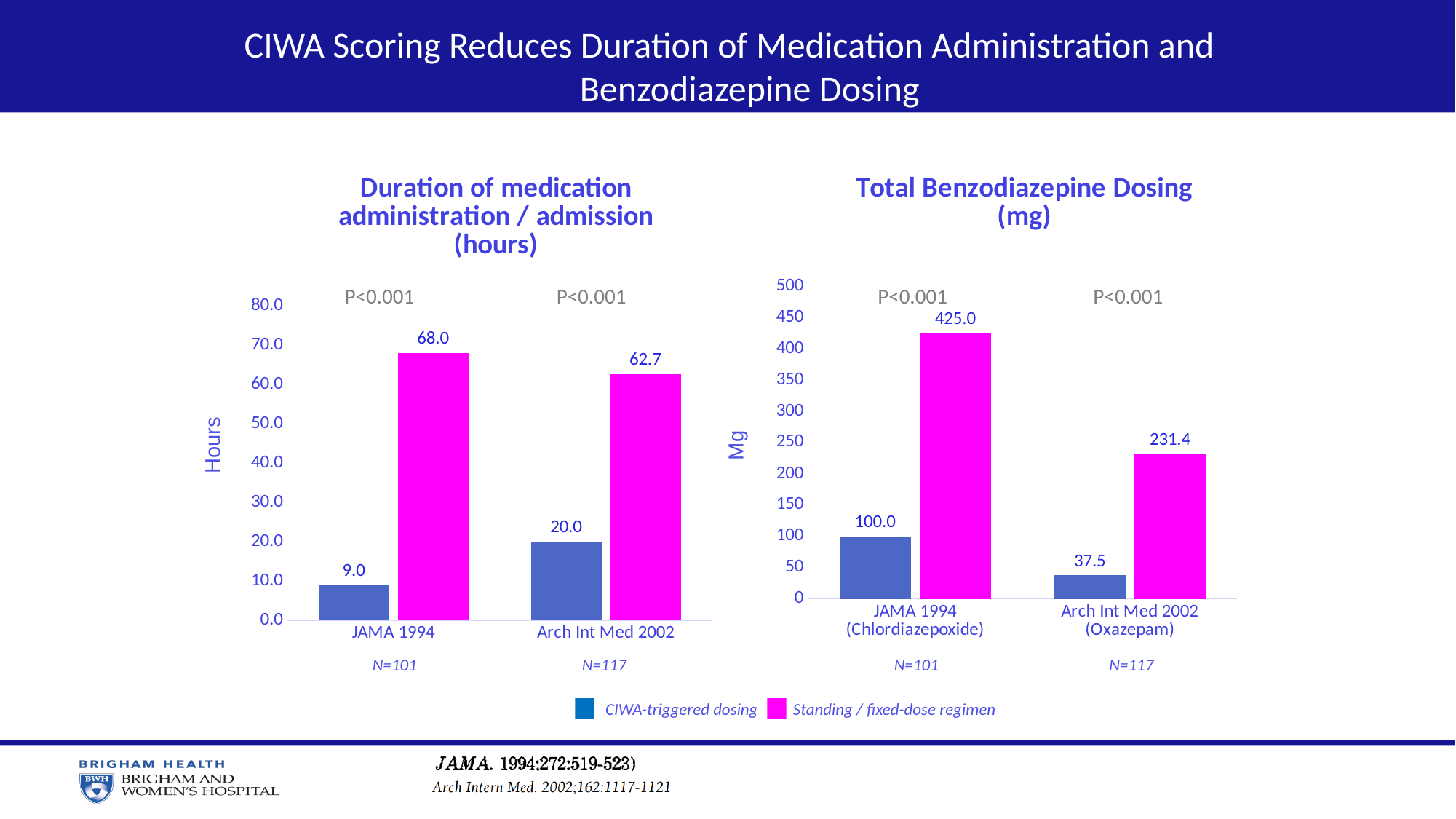
In the 'Total Benzodiazepine Dosing (mg)' chart, what is the value for the Standing / fixed-dose regimen in the JAMA 1994 (Chlordiazepoxide) study? 425.0 How many series does the legend list? 2 In the 'Duration of medication administration / admission (hours)' chart, which is larger: CIWA-triggered dosing for JAMA 1994 or CIWA-triggered dosing for Arch Int Med 2002? Arch Int Med 2002 In the 'Total Benzodiazepine Dosing (mg)' chart, which bar is the highest? Standing / fixed-dose regimen, JAMA 1994 (Chlordiazepoxide) In the 'Duration of medication administration / admission (hours)' chart, what is the value for the Standing / fixed-dose regimen in the Arch Int Med 2002 study? 62.7 In the 'Duration of medication administration / admission (hours)' chart, what is the value for CIWA-triggered dosing in the JAMA 1994 study? 9.0 In the 'Total Benzodiazepine Dosing (mg)' chart, what is the difference between the Standing / fixed-dose regimen and CIWA-triggered dosing values for Arch Int Med 2002 (Oxazepam)? 193.9 What is the y-axis label of the 'Duration of medication administration / admission (hours)' chart? Hours In the 'Total Benzodiazepine Dosing (mg)' chart, what is the value for CIWA-triggered dosing in the Arch Int Med 2002 (Oxazepam) study? 37.5 In the 'Duration of medication administration / admission (hours)' chart, what is the difference between the Standing / fixed-dose regimen and CIWA-triggered dosing values for JAMA 1994? 59.0 What kind of chart is the 'Total Benzodiazepine Dosing (mg)' chart? Bar chart In the 'Duration of medication administration / admission (hours)' chart, which bar is the lowest? CIWA-triggered dosing, JAMA 1994